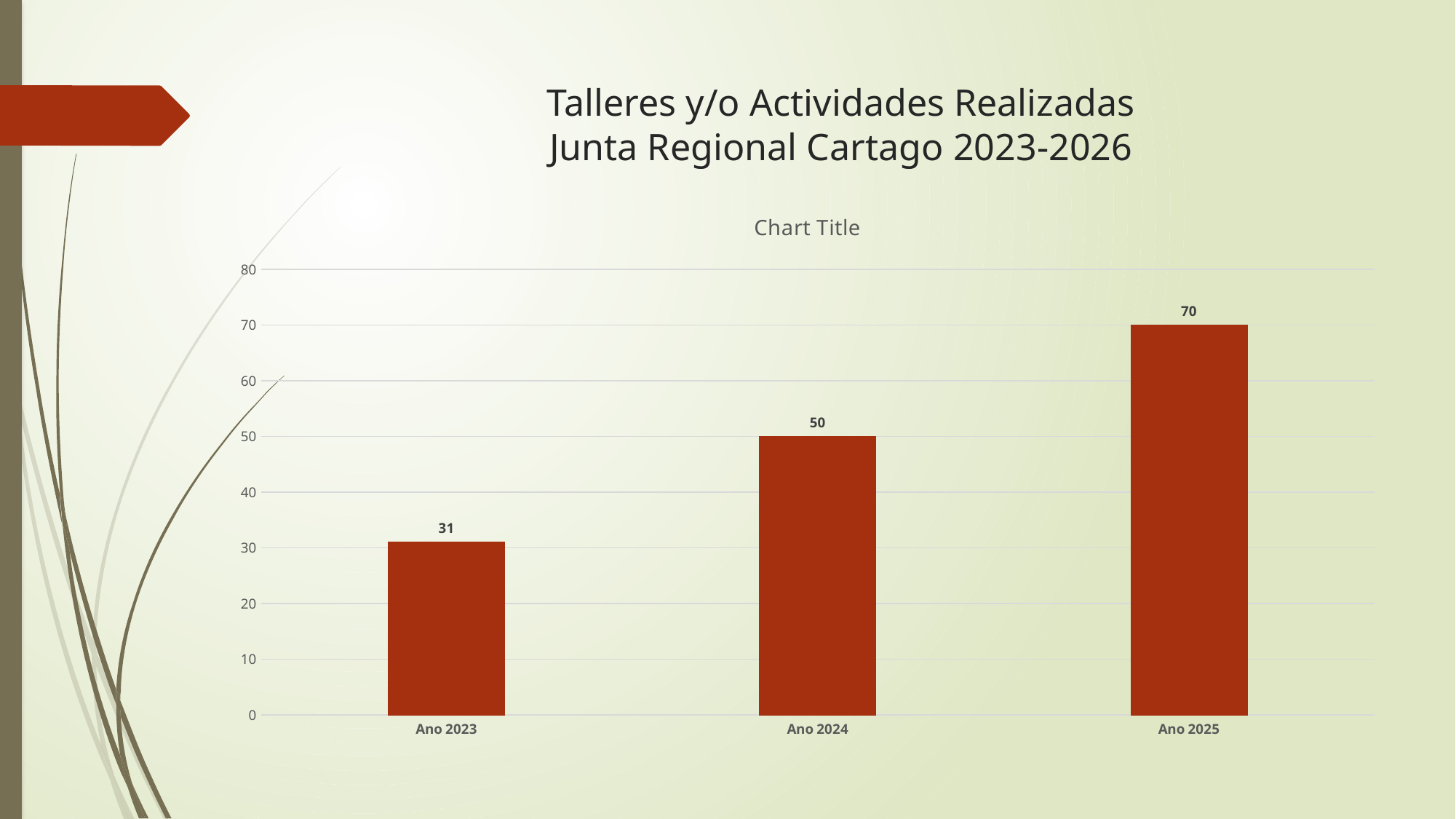
Do the values rise or fall from Ano 2023 to Ano 2025? rise Which year has the highest value? Ano 2025 What is the value for Ano 2025? 70 What is the value for Ano 2023? 31 What is the value for Ano 2024? 50 What is the difference between the values for Ano 2025 and Ano 2023? 39 What is the difference between the values for Ano 2024 and Ano 2023? 19 What kind of chart is shown on the slide? bar chart How many bars are shown in the chart? 3 Which year has the lowest value? Ano 2023 Is the value for Ano 2023 greater or less than 40? less Which is larger, the value for Ano 2024 or Ano 2025? Ano 2025